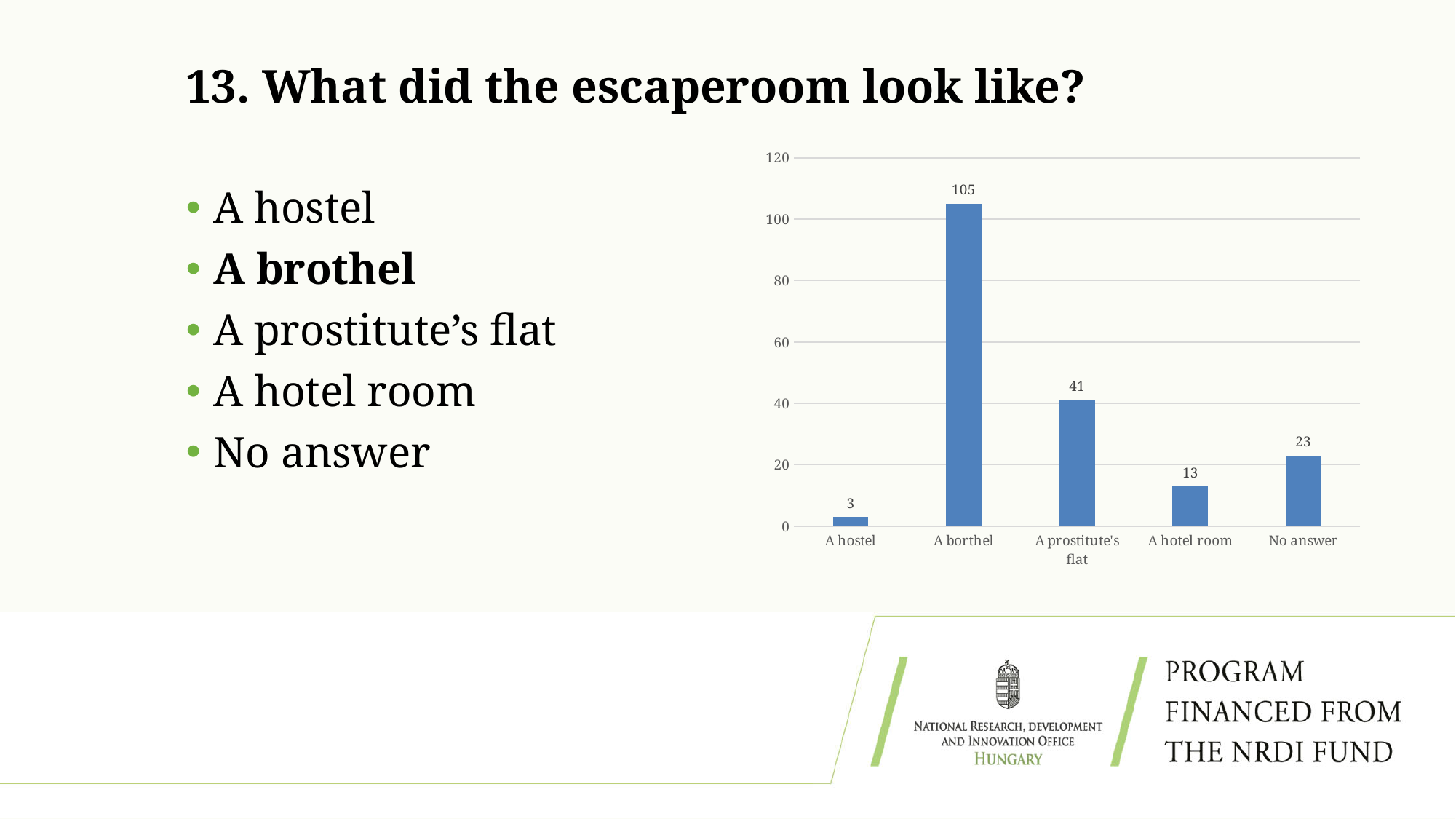
What is the difference between the values for "No answer" and "A hostel"? 20 What is the value for "A hotel room"? 13 Which category has the lowest value? A hostel What is the difference between the values for "A borthel" and "A prostitute's flat"? 64 What is the value for "A prostitute's flat"? 41 What kind of chart is shown on the slide? bar chart What is the value for "No answer"? 23 What is the value for "A borthel"? 105 Which category has the highest value? A borthel Which is larger, the value for "No answer" or the value for "A hotel room"? No answer Is the value for "A borthel" greater or less than 100? greater How many categories are shown on the x axis? 5